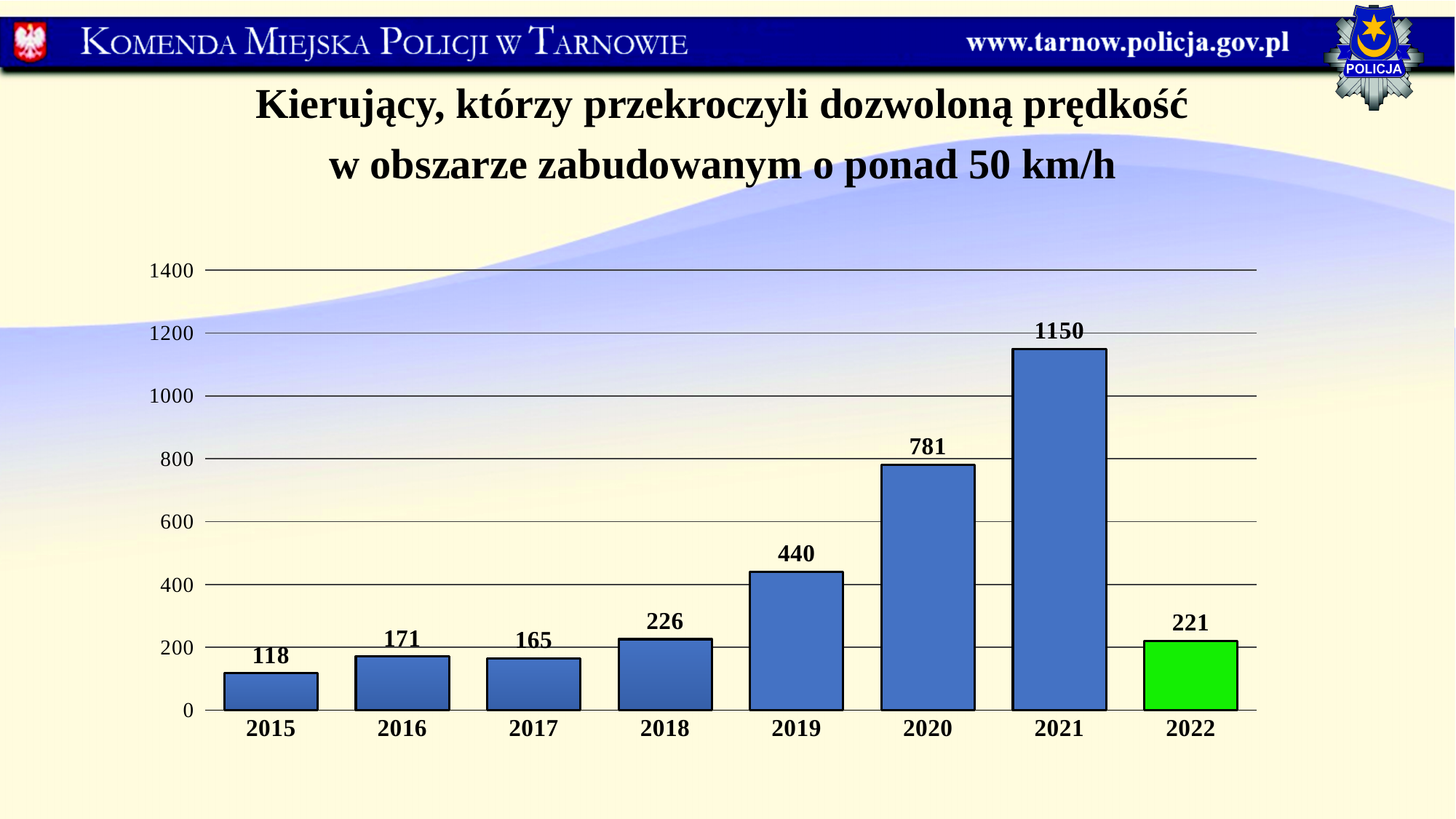
What is the value for 2021? 1150 Which year has the highest value? 2021 Is the value for 2020 greater or less than 600? greater What is the value for 2022? 221 What is the difference between the values for 2019 and 2018? 214 Which bar is coloured green rather than blue? 2022 How many years are shown on the x axis? 8 What is the difference between the values for 2021 and 2020? 369 Which year has the lowest value? 2015 Which is larger, the value for 2016 or the value for 2017? 2016 What kind of chart is shown on the slide? bar chart What is the value for 2015? 118